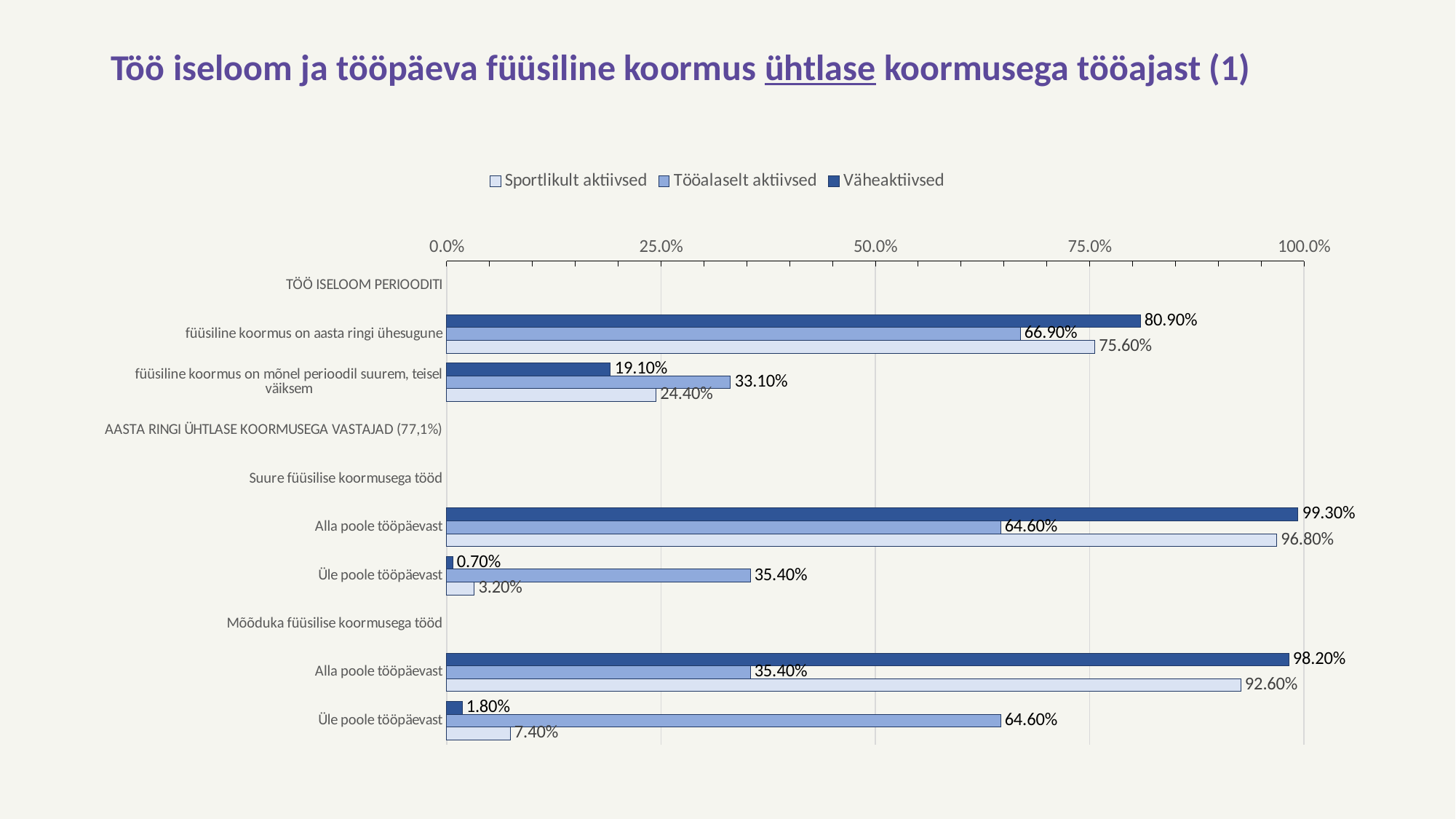
What kind of chart is shown on the slide? bar chart Is the Sportlikult aktiivsed value for 'füüsiline koormus on mõnel perioodil suurem, teisel väiksem' greater or less than 25.0%? less How many series does the legend list? 3 Under 'Suure füüsilise koormusega tööd', what is the value for Sportlikult aktiivsed for 'Alla poole tööpäevast'? 96.80% What is the difference between the Väheaktiivsed and Sportlikult aktiivsed values in the category 'füüsiline koormus on aasta ringi ühesugune'? 5.30% Which legend entry is shown in the darkest blue colour? Väheaktiivsed What is the value for Tööalaselt aktiivsed in the category 'füüsiline koormus on mõnel perioodil suurem, teisel väiksem'? 33.10% Which series has the highest value in the category 'füüsiline koormus on aasta ringi ühesugune'? Väheaktiivsed Under 'Mõõduka füüsilise koormusega tööd', what is the value for Tööalaselt aktiivsed for 'Üle poole tööpäevast'? 64.60% What is the value for Väheaktiivsed in the category 'füüsiline koormus on aasta ringi ühesugune'? 80.90% Which series has the lowest value for 'Üle poole tööpäevast' under 'Suure füüsilise koormusega tööd'? Väheaktiivsed Under 'Mõõduka füüsilise koormusega tööd', which is larger for 'Alla poole tööpäevast': Väheaktiivsed or Tööalaselt aktiivsed? Väheaktiivsed